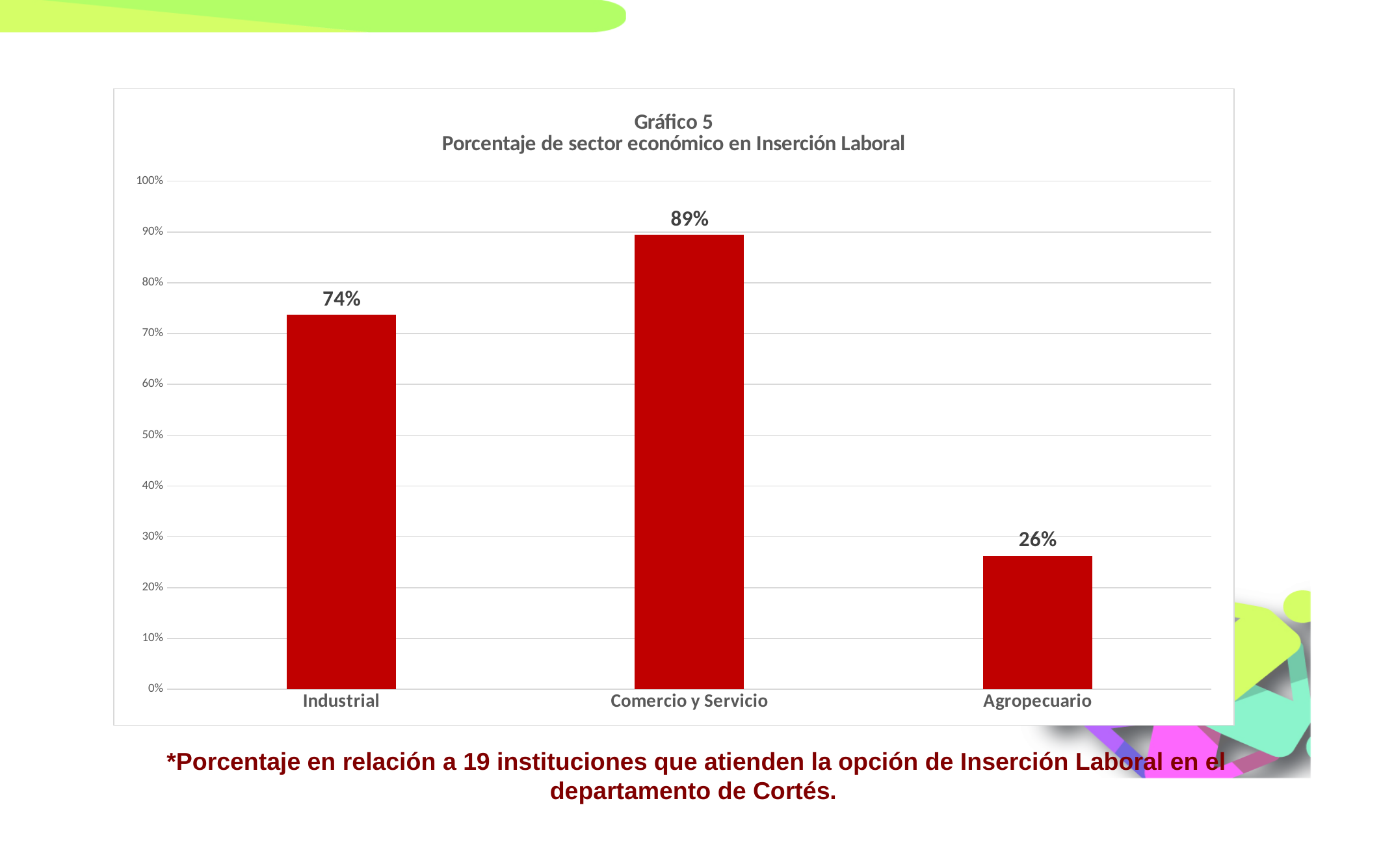
What kind of chart is shown on the slide? bar chart Which sector has the highest percentage? Comercio y Servicio What is the value for Agropecuario? 26% What is the title of the chart? Gráfico 5 Porcentaje de sector económico en Inserción Laboral What is the value for Industrial? 74% What is the value for Comercio y Servicio? 89% How many sectors are shown on the chart? 3 Which is larger, the value for Industrial or the value for Agropecuario? Industrial What is the difference between the values for Comercio y Servicio and Industrial? 15% What is the difference between the values for Industrial and Agropecuario? 48% Is the value for Agropecuario greater or less than 30%? less Which sector has the lowest percentage? Agropecuario